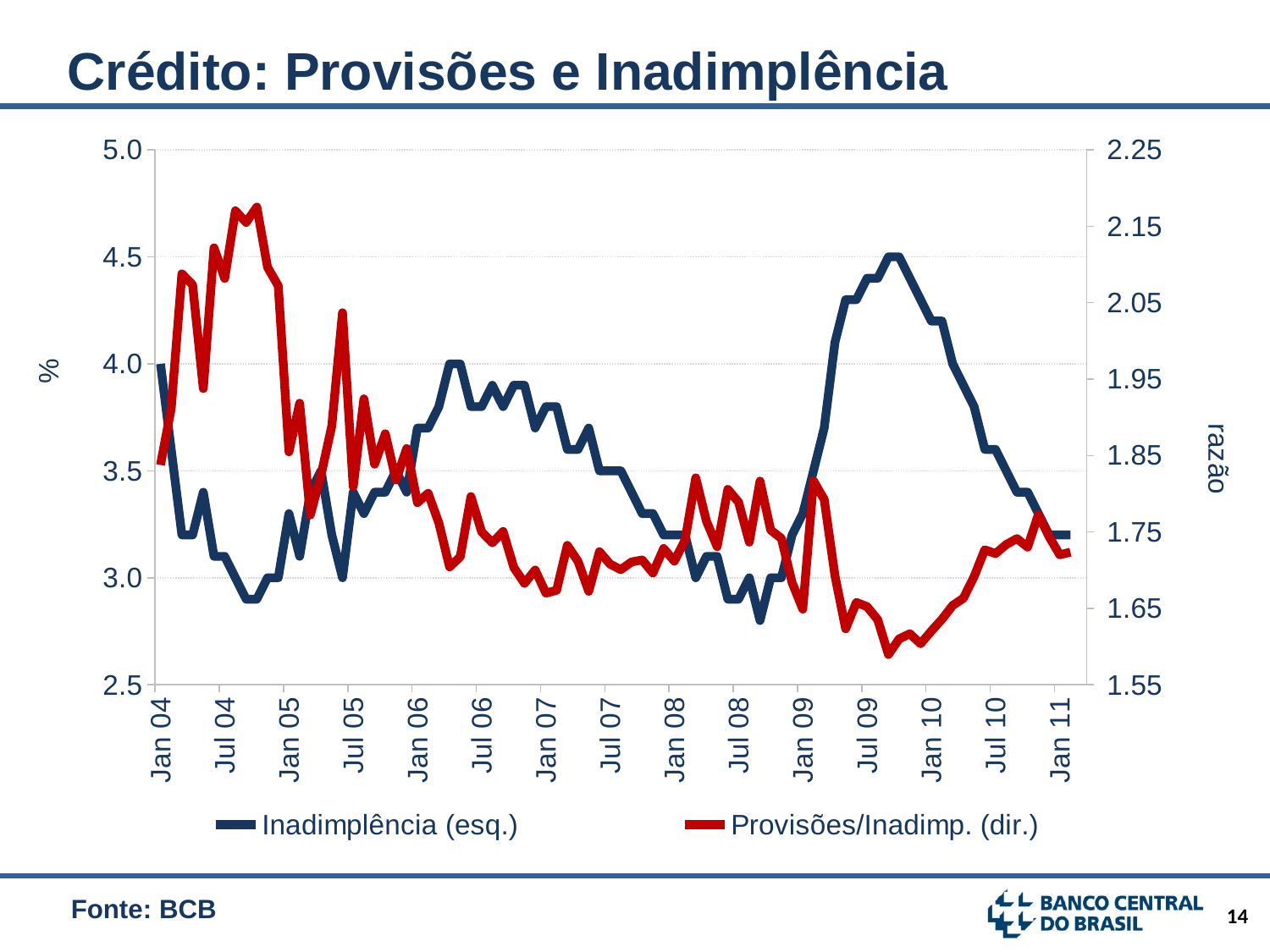
Is the value of Provisões/Inadimp. at Jan 10 greater or less than 1.75? less In which year does Provisões/Inadimp. reach its highest value? 2004 How many series does the legend list? 2 Does Inadimplência rise or fall between Jan 09 and Jul 09? rise Is the value of Inadimplência at Jul 09 greater or less than 4.0? greater Is the value of Inadimplência at Jan 08 greater or less than 3.5? less What is the title of the chart? Crédito: Provisões e Inadimplência Which series is plotted against the right-hand axis according to the legend? Provisões/Inadimp. (dir.) Does Inadimplência rise or fall between Jul 09 and Jan 11? fall What kind of chart is shown on the slide? line chart